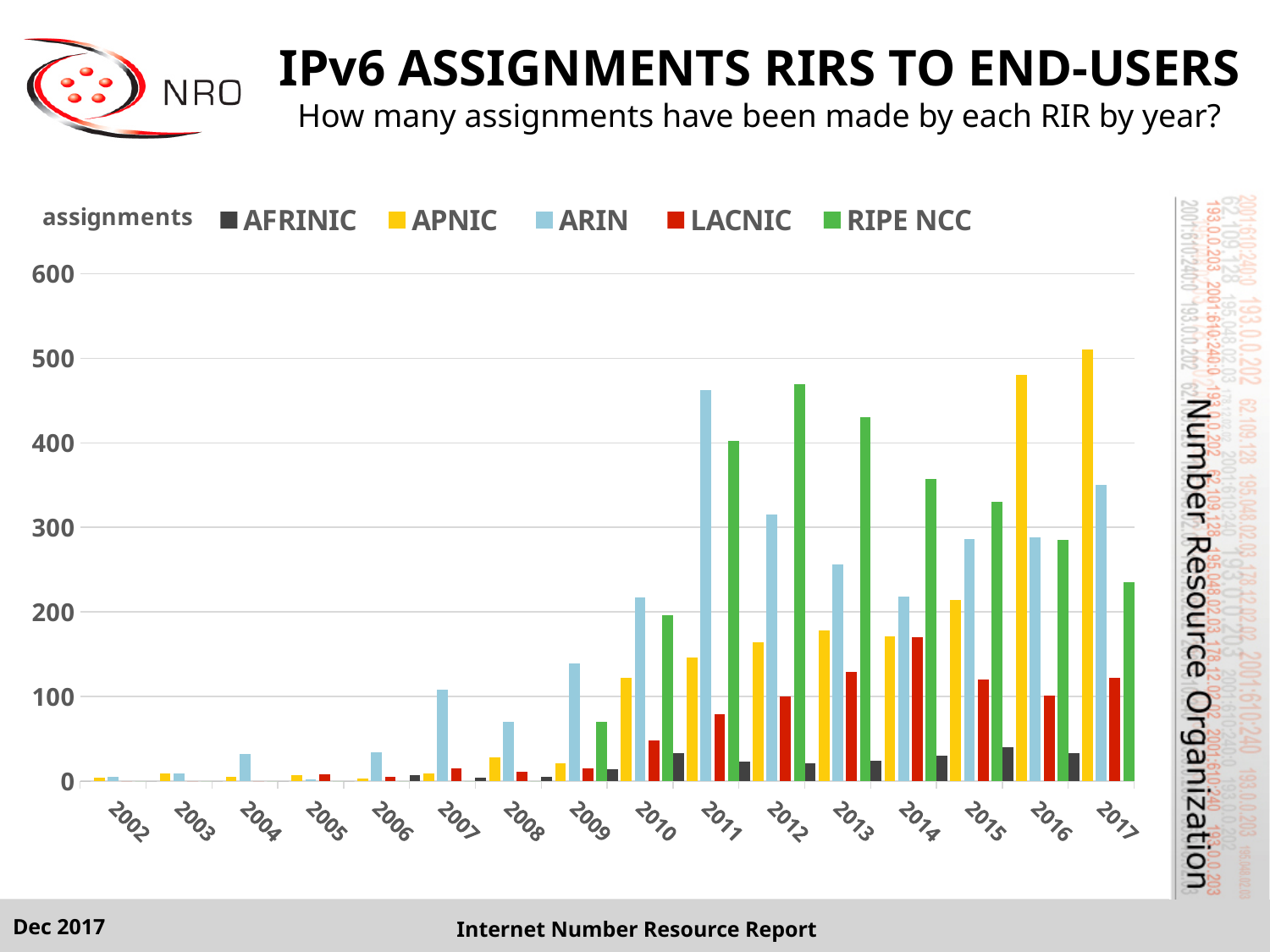
How many years are shown along the x axis? 16 Is the value for RIPE NCC in 2017 greater or less than 300? less Is the value for APNIC in 2017 greater or less than 400? greater Is the value for ARIN in 2011 greater or less than 400? greater Which RIR has the highest number of assignments in 2012? RIPE NCC Do the APNIC values rise or fall from 2014 to 2017? rise What is the title of the chart? IPv6 ASSIGNMENTS RIRS TO END-USERS How many series does the legend list? 5 In 2016, which is larger: the value for APNIC or the value for ARIN? APNIC Which RIR has the highest number of assignments in 2011? ARIN What kind of chart is shown on the slide? bar chart Which RIR has the highest number of assignments in 2017? APNIC